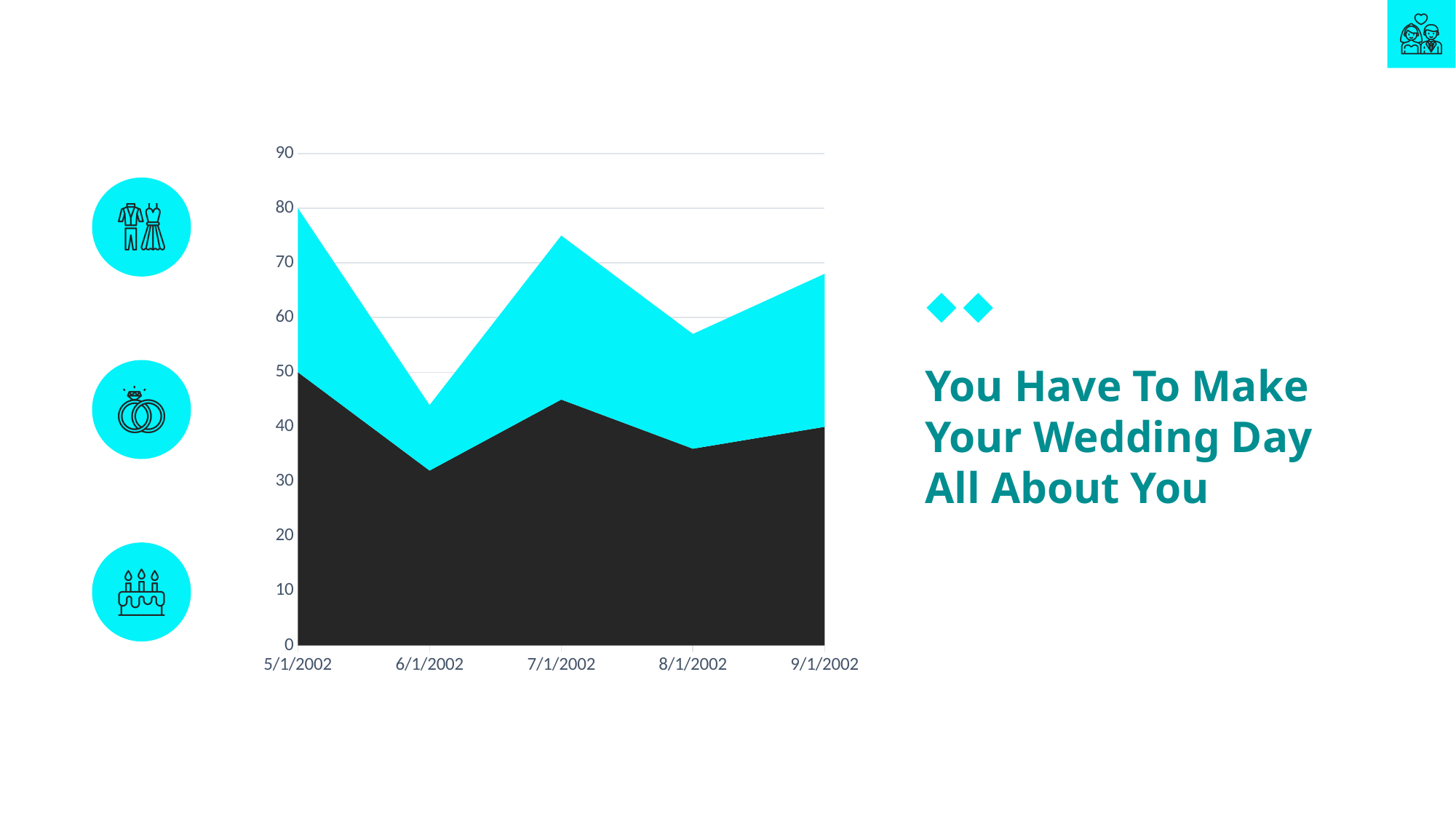
Which date has the larger value for the bottom (dark) series, 7/1/2002 or 8/1/2002? 7/1/2002 Is the value of the bottom (dark) series at 5/1/2002 greater or less than 40? greater Is the top of the stacked area at 6/1/2002 greater or less than 50? less How many dates are shown on the x axis of the chart? 5 At which date does the bottom (dark) series reach its highest value? 5/1/2002 At which date is the top of the stacked area lowest? 6/1/2002 Is the top of the stacked area at 7/1/2002 greater or less than 70? greater What kind of chart is shown on the slide? area chart How many series are stacked in the area chart? 2 Does the bottom (dark) series rise or fall from 5/1/2002 to 6/1/2002? fall What colour is the upper series in the stacked area chart? cyan